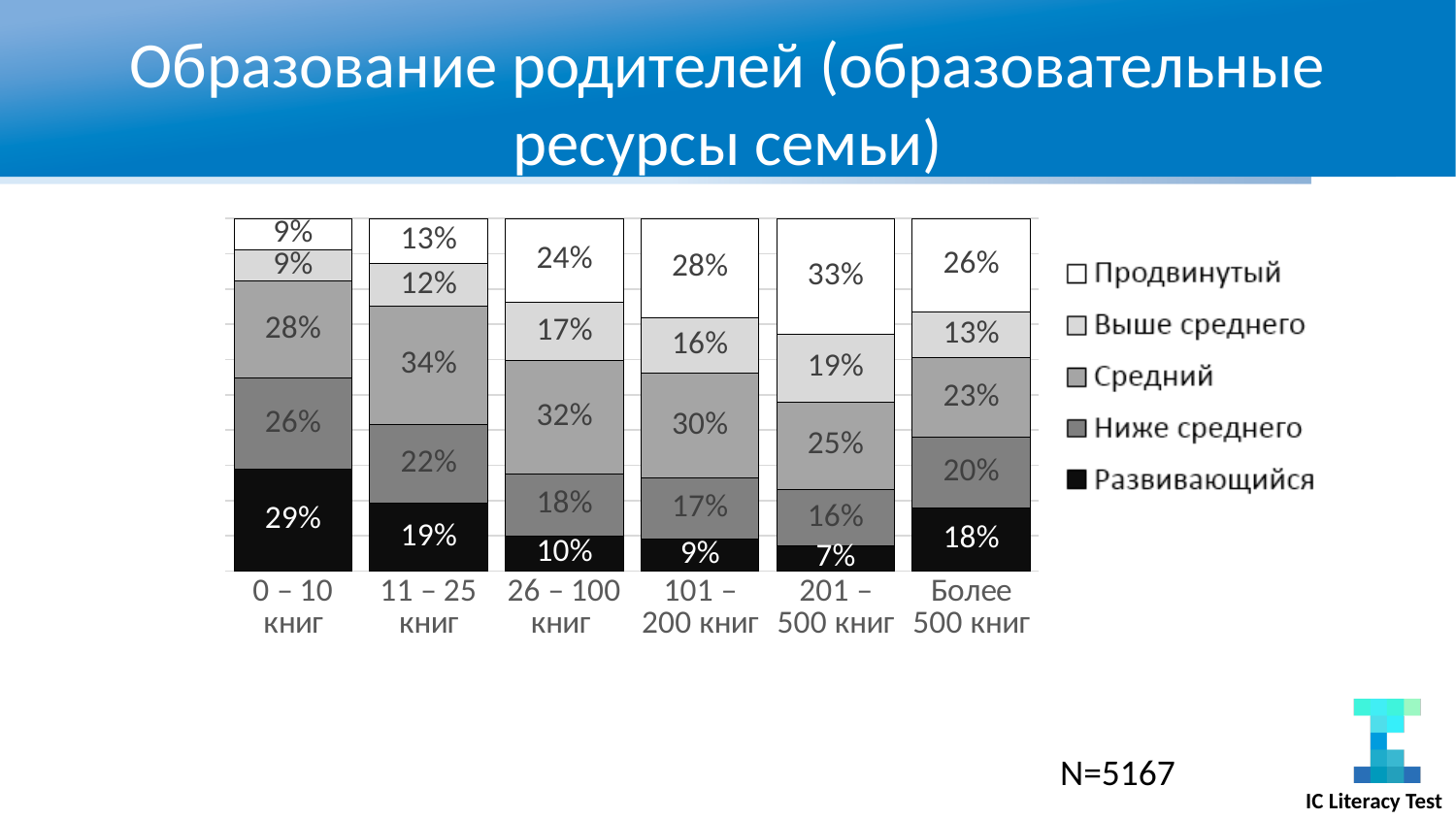
Which category has the highest Продвинутый value? 201 – 500 книг What is the difference between the Продвинутый values for 101 – 200 книг and 0 – 10 книг? 19% How many categories (book-count groups) are shown on the x axis? 6 What is the value of the Средний segment for the 11 – 25 книг category? 34% Which is larger: the Ниже среднего value for 0 – 10 книг or for 26 – 100 книг? 0 – 10 книг Which series is shown in black in the legend? Развивающийся What is the value of the Развивающийся segment for the 0 – 10 книг category? 29% Which category has the lowest Развивающийся value? 201 – 500 книг What is the value of the Продвинутый segment for the 201 – 500 книг category? 33% What is the value of the Выше среднего segment for the Более 500 книг category? 13% How many series does the legend list? 5 What kind of chart is shown on the slide? Stacked bar chart